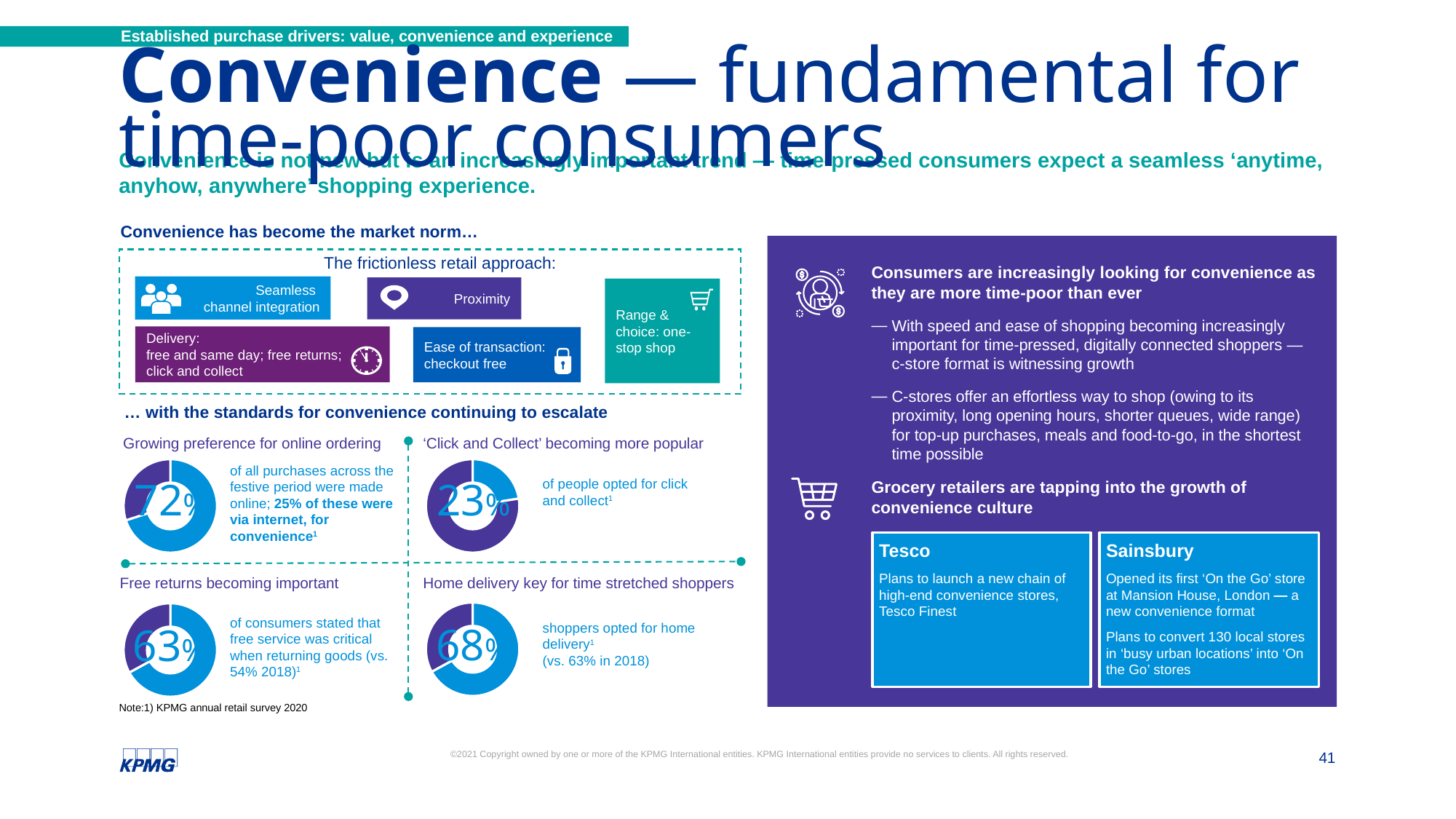
In the 'Growing preference for online ordering' donut chart, what percentage of all purchases across the festive period were made online? 72% What kind of chart is used to show the 72% figure under 'Growing preference for online ordering'? Donut chart Which is larger: the percentage in the 'Home delivery key for time stretched shoppers' donut chart or the percentage in the 'Free returns becoming important' donut chart? Home delivery key for time stretched shoppers (68%) In the ''Click and Collect' becoming more popular' donut chart, what percentage of people opted for click and collect? 23% What source is cited in the note below the donut charts? KPMG annual retail survey 2020 Which of the four donut charts shows the highest percentage? Growing preference for online ordering (72%) In the 'Home delivery key for time stretched shoppers' donut chart, what percentage of shoppers opted for home delivery? 68% How many donut charts are shown in the '… with the standards for convenience continuing to escalate' section of the slide? 4 In the 'Home delivery key for time stretched shoppers' donut chart, by how many percentage points did the share of shoppers opting for home delivery rise from the 63% in 2018 to the value shown? 5 percentage points Which of the four donut charts shows the lowest percentage? 'Click and Collect' becoming more popular (23%) In the 'Free returns becoming important' donut chart, what percentage of consumers stated that free service was critical when returning goods? 63% What is the difference between the percentage in the 'Growing preference for online ordering' donut chart and the percentage in the ''Click and Collect' becoming more popular' donut chart? 49 percentage points